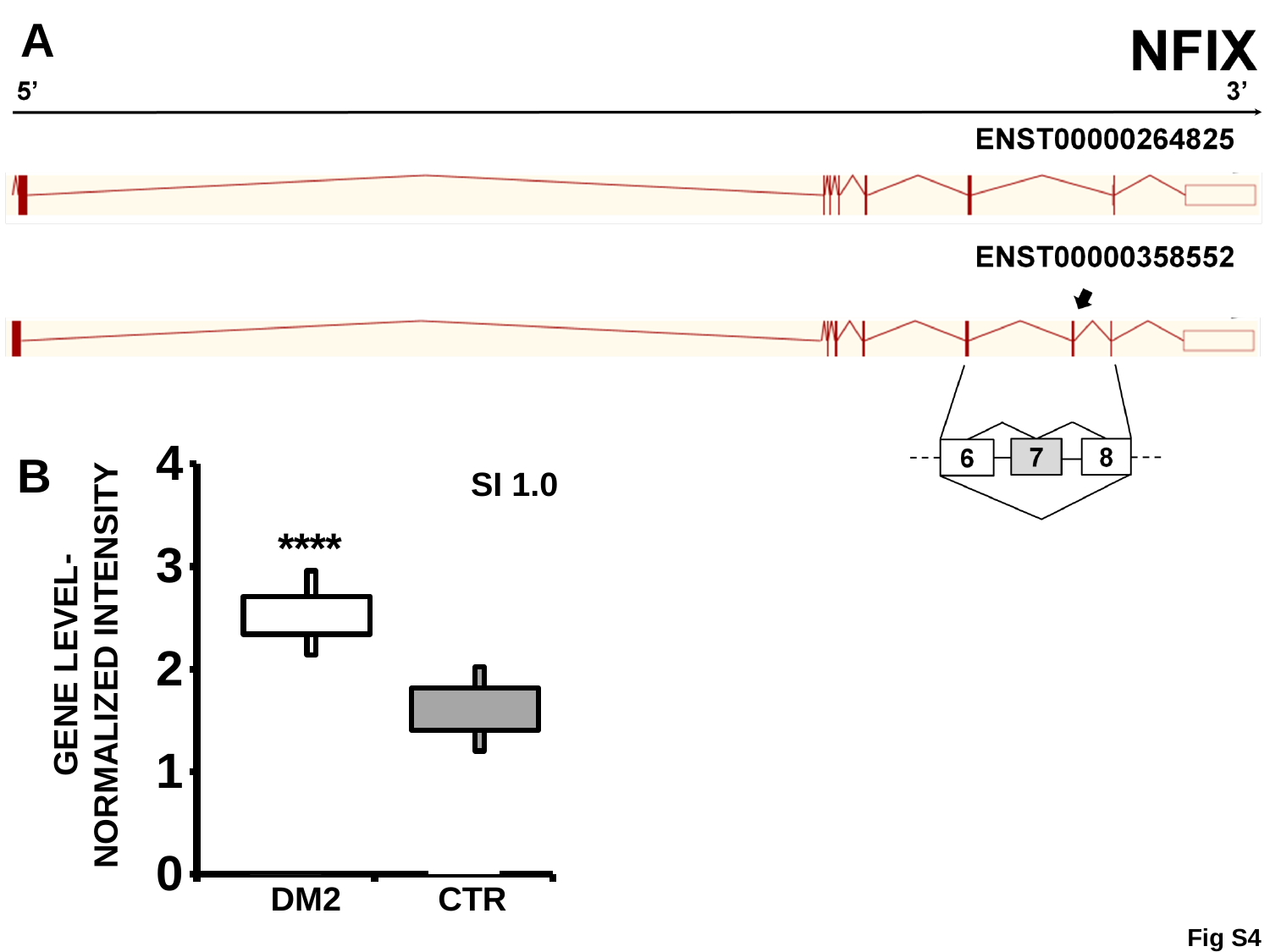
In panel B, is the median value for CTR greater or less than 1? greater In panel B, which category shows the highest gene level-normalized intensity? DM2 In panel B, what annotation is printed in the upper right of the plot area? SI 1.0 In panel B, which category has the higher gene level-normalized intensity, DM2 or CTR? DM2 In panel B, is the median value for DM2 greater or less than 2? greater In panel B, how many categories are shown on the x axis? 2 In panel B, is the median value for DM2 greater or less than 3? less In panel B, which category shows the lowest gene level-normalized intensity? CTR In panel B, what kind of chart is shown? box plot In panel B, what is the label of the y axis? GENE LEVEL-NORMALIZED INTENSITY